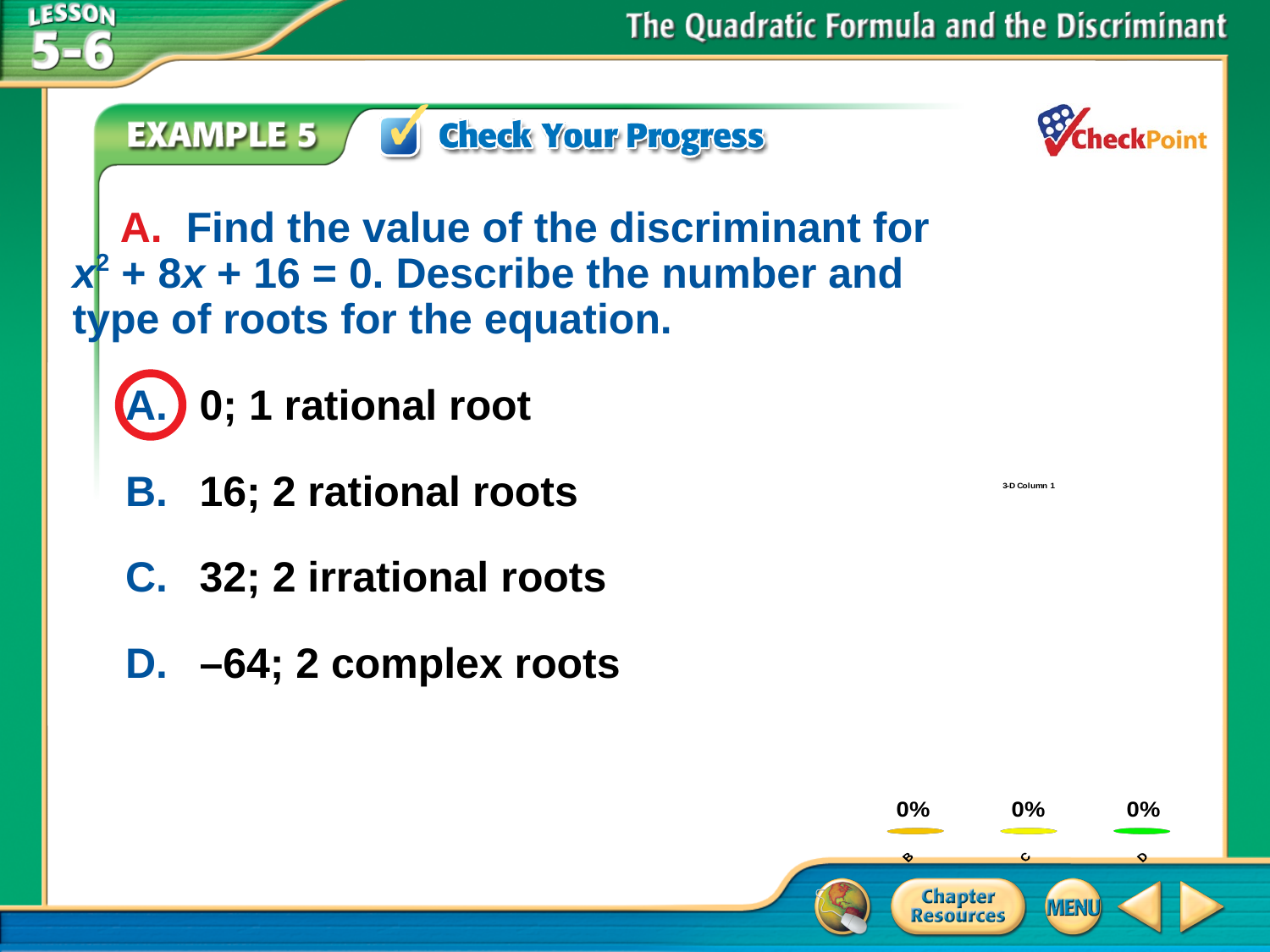
What value is shown for category C in the chart? 0% What value is shown for category D in the chart? 0% What value is shown for category B in the chart? 0% What kind of chart is shown on the slide? bar chart What is the difference between the values for B and D in the chart? 0%